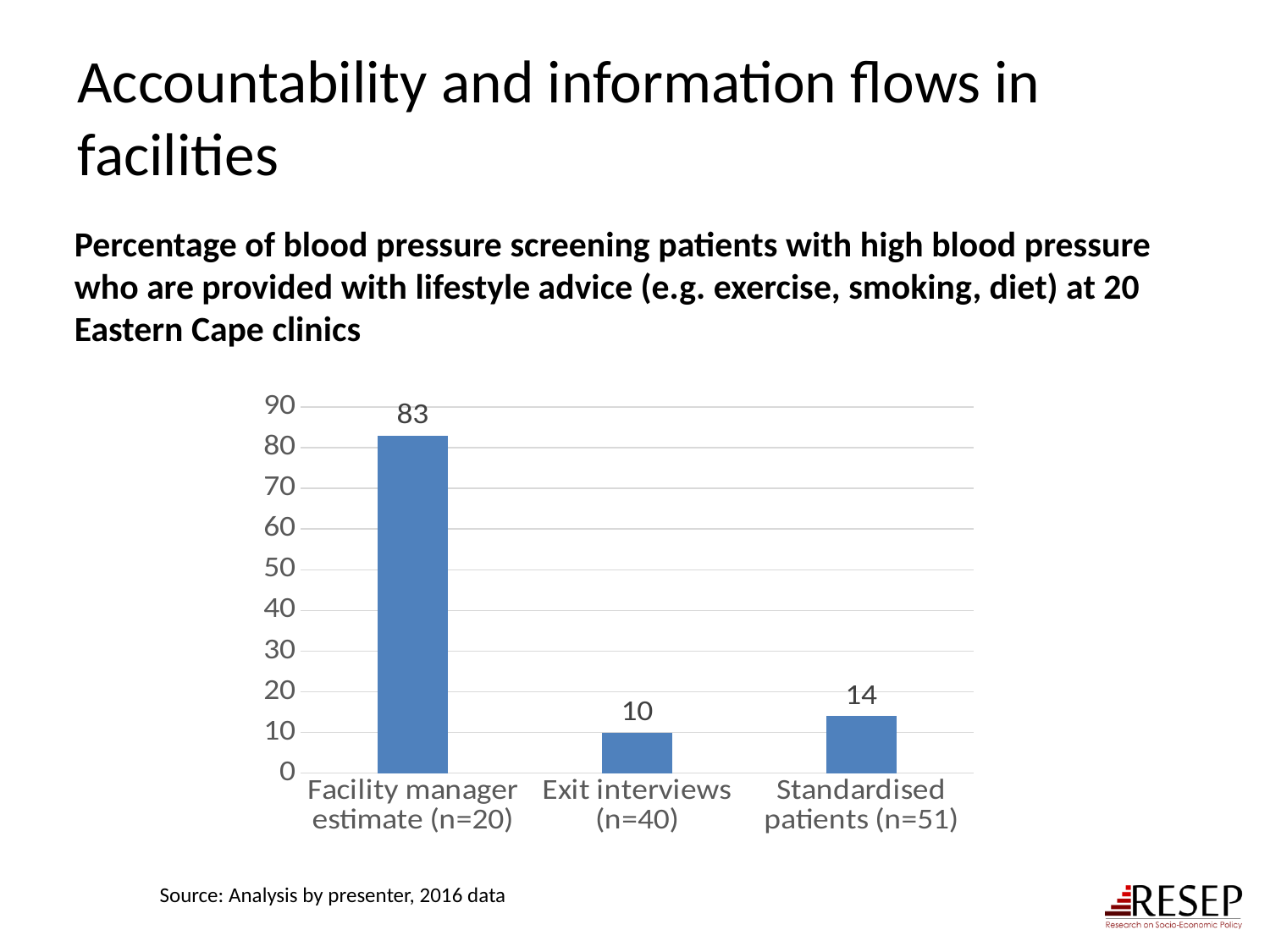
Which category has the lowest value? Exit interviews (n=40) How many categories are shown on the chart? 3 Which category has the highest value? Facility manager estimate (n=20) What is the value for Facility manager estimate (n=20)? 83 What is the highest value shown on the vertical axis? 90 What is the value for Standardised patients (n=51)? 14 Is the value for Facility manager estimate (n=20) greater or less than 80? greater Which is larger, the value for Standardised patients (n=51) or the value for Exit interviews (n=40)? Standardised patients (n=51) What is the value for Exit interviews (n=40)? 10 What kind of chart is shown on the slide? Bar chart What is the difference between the Standardised patients (n=51) and the Exit interviews (n=40) values? 4 What is the difference between the Facility manager estimate (n=20) and the Exit interviews (n=40) values? 73